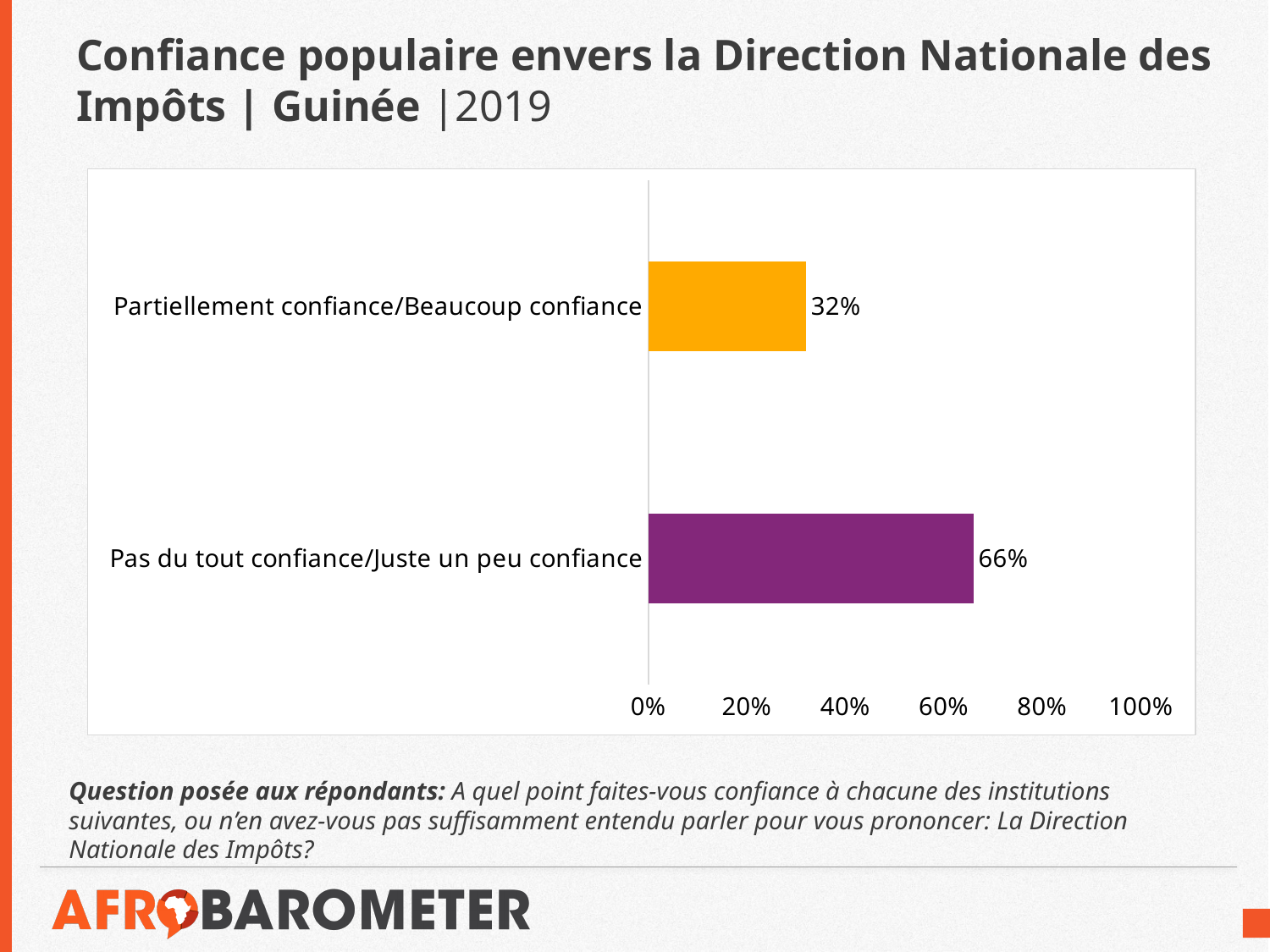
Which category has the highest value? Pas du tout confiance/Juste un peu confiance Is the value for "Partiellement confiance/Beaucoup confiance" greater or less than 40%? less What is the maximum value shown on the x axis? 100% Is the value for "Pas du tout confiance/Juste un peu confiance" greater or less than 60%? greater Which category has the lowest value? Partiellement confiance/Beaucoup confiance What is the value for "Pas du tout confiance/Juste un peu confiance"? 66% What is the value for "Partiellement confiance/Beaucoup confiance"? 32% What kind of chart is shown on the slide? Bar chart How many categories are shown in the chart? 2 What is the difference between the values for "Pas du tout confiance/Juste un peu confiance" and "Partiellement confiance/Beaucoup confiance"? 34% Which is larger: the value for "Partiellement confiance/Beaucoup confiance" or for "Pas du tout confiance/Juste un peu confiance"? Pas du tout confiance/Juste un peu confiance What colour is the bar for "Pas du tout confiance/Juste un peu confiance"? Purple